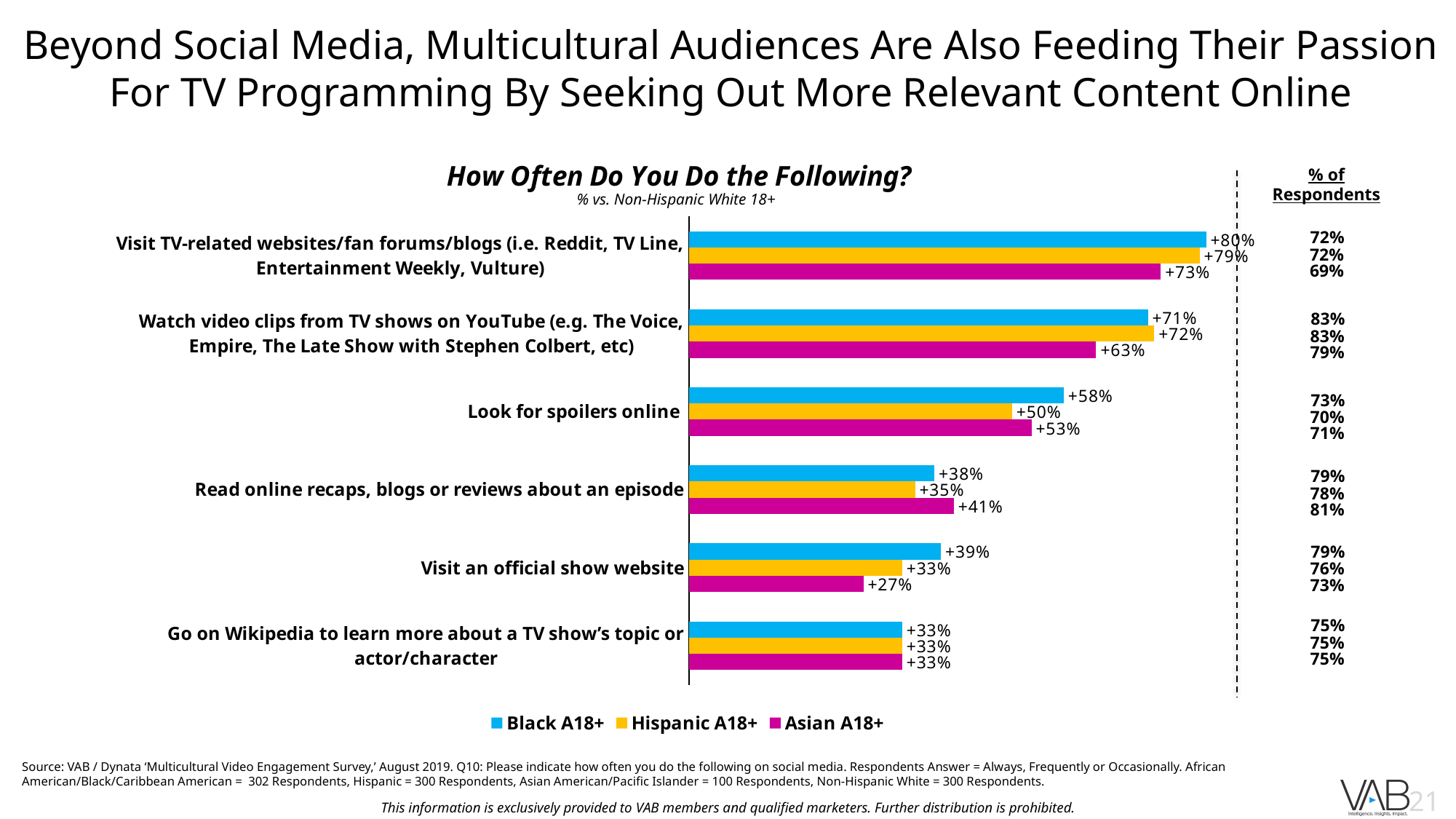
What is the value for Black A18+ for 'Look for spoilers online'? +58% Which activity has the lowest value for Asian A18+? Visit an official show website Which activity has the highest value for Black A18+? Visit TV-related websites/fan forums/blogs What is the '% of Respondents' value for Asian A18+ for 'Watch video clips from TV shows on YouTube'? 79% What is the value for Asian A18+ for 'Visit an official show website'? +27% What colour represents Hispanic A18+ in the chart? Yellow/orange How many series does the legend list? 3 For 'Read online recaps, blogs or reviews about an episode', which is larger: the Black A18+ value or the Asian A18+ value? Asian A18+ What is the difference between the Black A18+ and Hispanic A18+ values for 'Look for spoilers online'? 8% What is the value for Hispanic A18+ for 'Watch video clips from TV shows on YouTube'? +72% How many activities (categories) are shown in the chart? 6 What kind of chart is shown on the slide? Bar chart